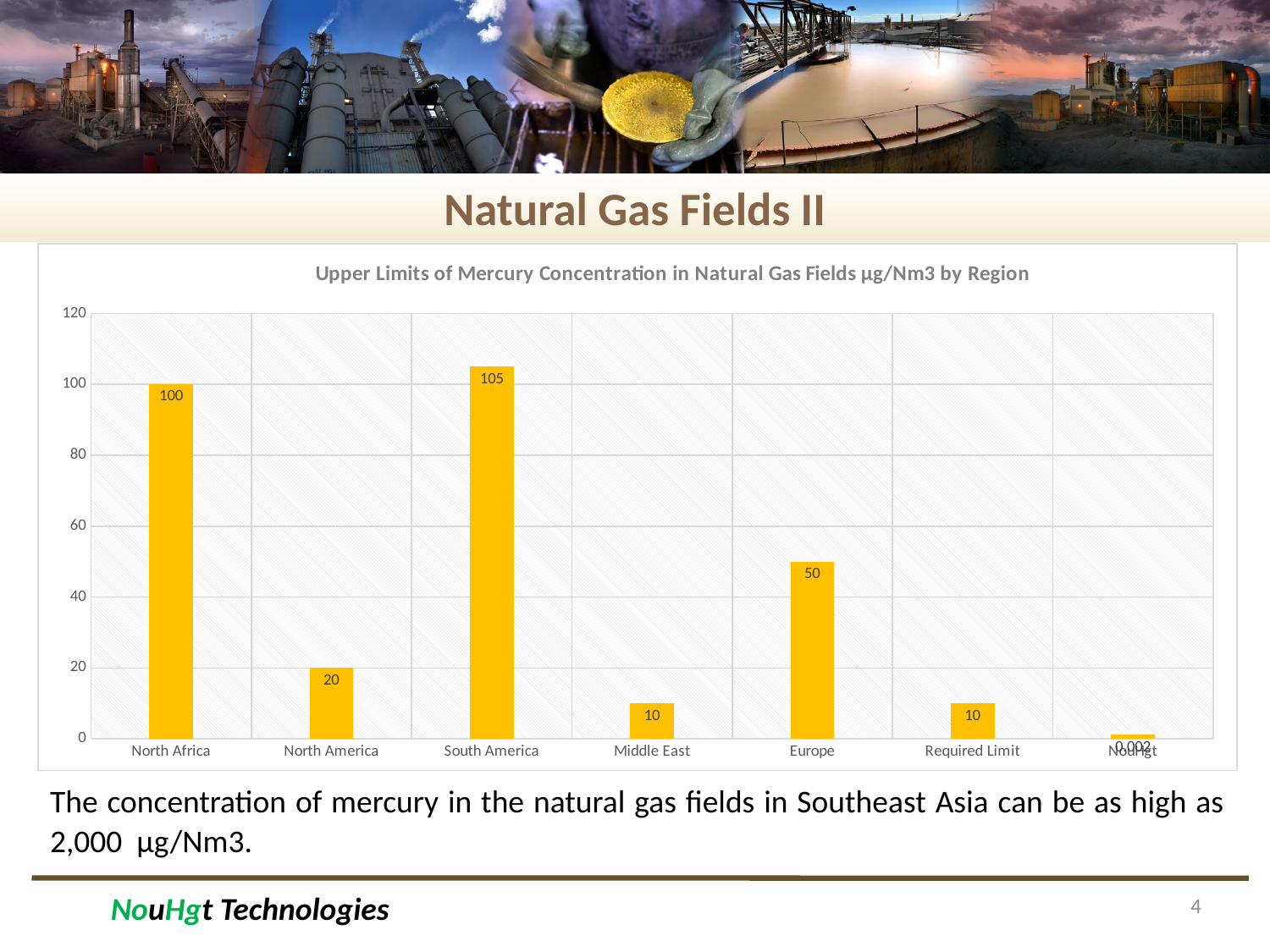
What is the difference between the values for Europe and the Middle East? 40 What is the value for North America? 20 Which is larger, the value for Europe or the value for North America? Europe What type of chart is shown on the slide? Bar chart What is the difference between the values for South America and North Africa? 5 What is the value for the Required Limit? 10 Which region has the highest upper limit of mercury concentration? South America What is the value for Europe? 50 How many bars are shown in the chart? 7 Is the value for Europe greater or less than 60? less What is the value for North Africa? 100 What is the value for South America? 105